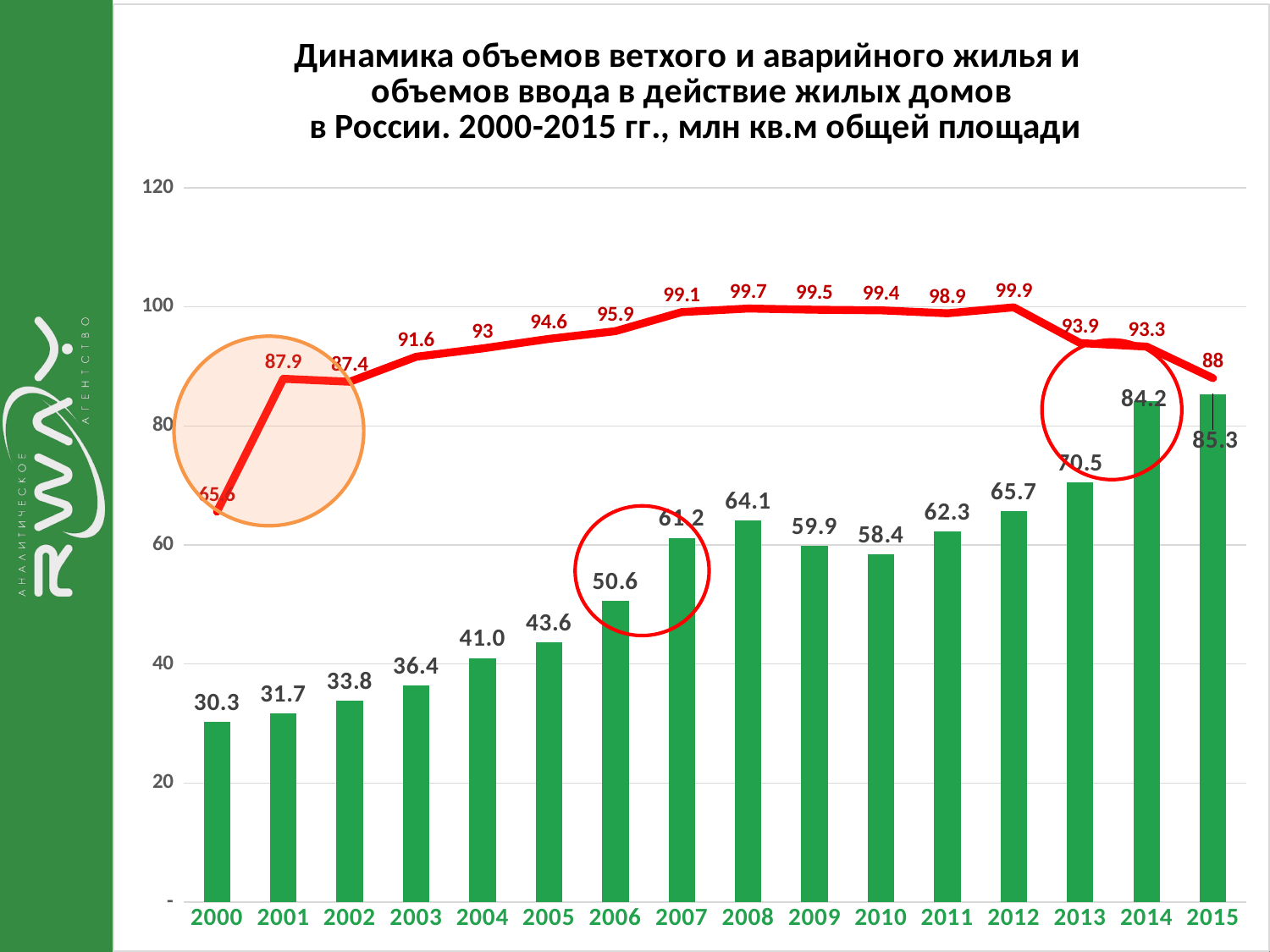
What is the value of the green bar for 2006? 50.6 Which year has the lowest green bar? 2000 Is the red line value for 2015 greater or less than 80? greater What kind of chart is shown on the slide? A bar chart combined with a line chart How many years are shown on the x axis? 16 What is the difference between the red line values for 2013 and 2015? 5.9 What is the difference between the green bar values for 2015 and 2014? 1.1 Do the green bar values rise or fall from 2000 to 2008? rise What value does the red line show for 2012? 99.9 What is the value of the green bar for 2008? 64.1 Which year has the highest green bar? 2015 Which green bar is taller, 2009 or 2010? 2009